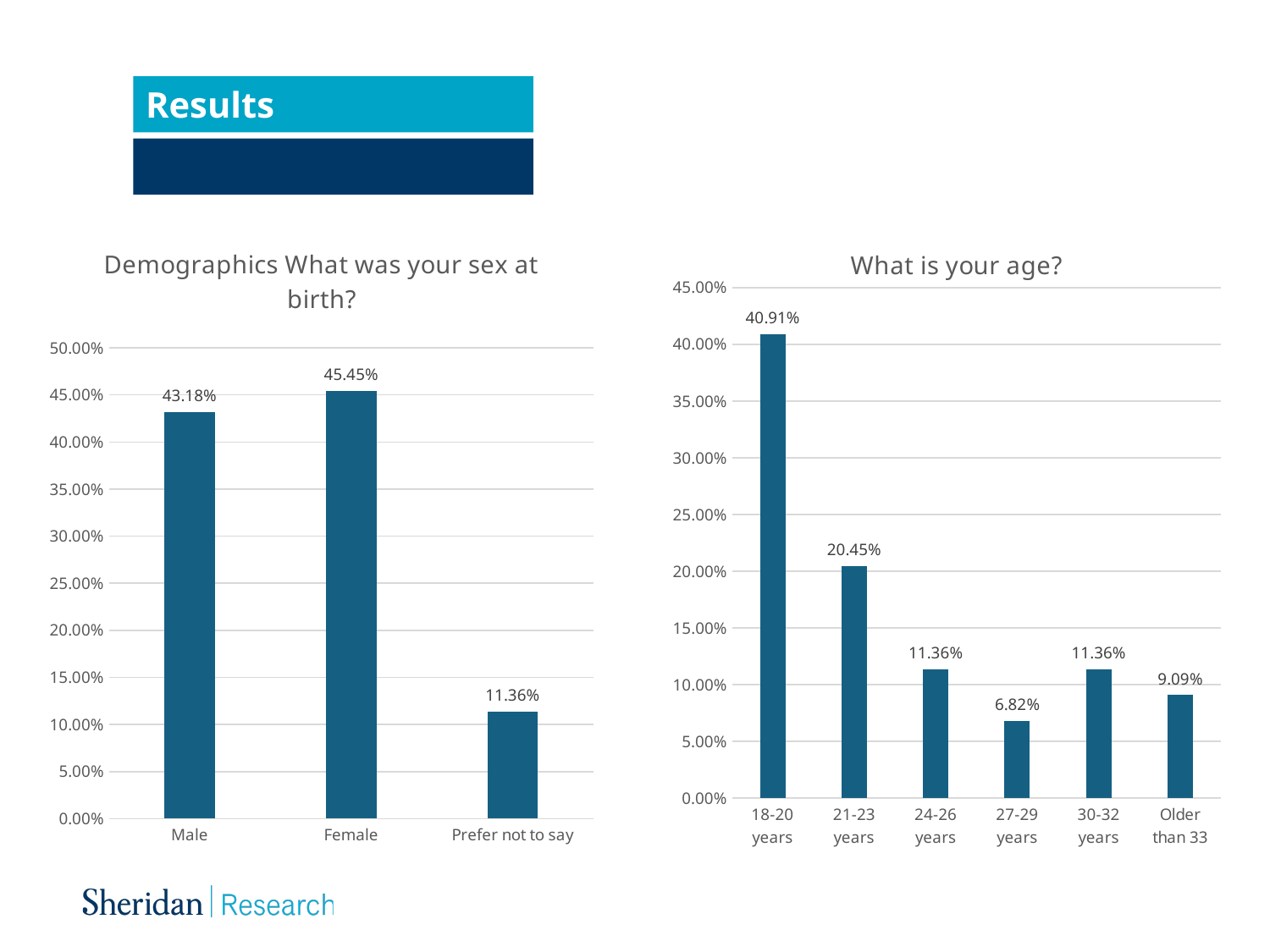
In the 'What is your age?' chart, which is larger, the value for 21-23 years or the value for Older than 33? 21-23 years In the 'What is your age?' chart, what is the value for 27-29 years? 6.82% In the 'What is your age?' chart, which category has the lowest value? 27-29 years In the 'Demographics What was your sex at birth?' chart, how many categories are shown? 3 In the 'What is your age?' chart, what is the difference between the 18-20 years and 21-23 years values? 20.46% What type of chart is the 'What is your age?' chart? Bar chart In the 'What is your age?' chart, how many age categories are shown? 6 In the 'Demographics What was your sex at birth?' chart, which category has the highest value? Female In the 'Demographics What was your sex at birth?' chart, what is the value for Prefer not to say? 11.36% In the 'What is your age?' chart, what is the value for 18-20 years? 40.91% In the 'Demographics What was your sex at birth?' chart, what is the value for Female? 45.45% In the 'Demographics What was your sex at birth?' chart, what is the difference between the Female and Male values? 2.27%